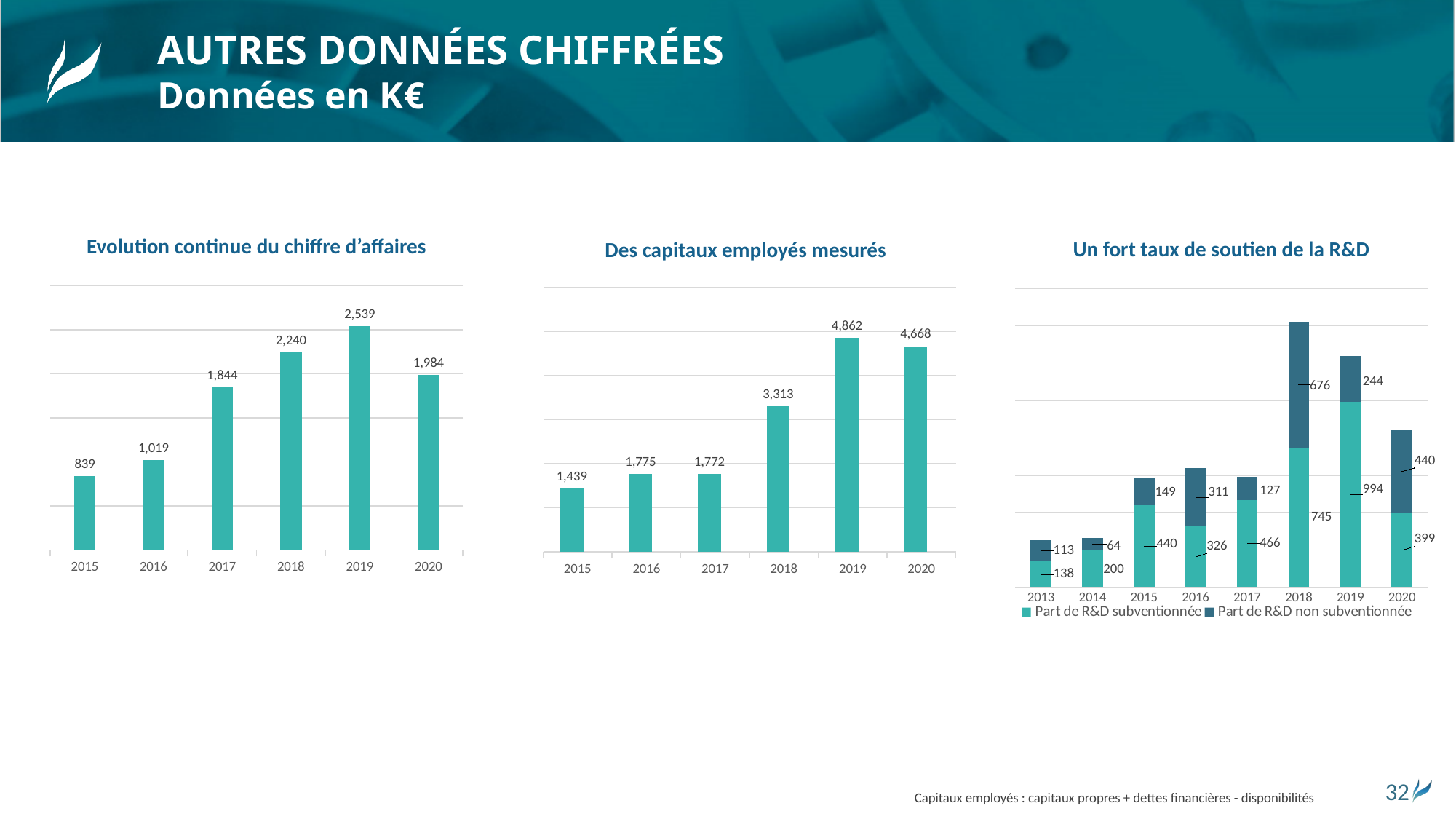
In the chart 'Evolution continue du chiffre d'affaires', what is the value for 2019? 2,539 In the chart 'Des capitaux employés mesurés', what is the value for 2018? 3,313 In the chart 'Un fort taux de soutien de la R&D', what is the value of 'Part de R&D non subventionnée' for 2016? 311 What kind of chart is 'Un fort taux de soutien de la R&D'? Stacked bar chart In the chart 'Des capitaux employés mesurés', is the value for 2018 larger than the value for 2017? Yes, 2018 In the chart 'Des capitaux employés mesurés', which year has the highest value? 2019 In the chart 'Un fort taux de soutien de la R&D', what is the value of 'Part de R&D subventionnée' for 2019? 994 In the chart 'Un fort taux de soutien de la R&D', what is the total of the stacked bar for 2018? 1,421 In the chart 'Un fort taux de soutien de la R&D', how many series does the legend list? 2 In the chart 'Des capitaux employés mesurés', how many years are shown on the x axis? 6 In the chart 'Evolution continue du chiffre d'affaires', what is the difference between the 2019 and 2020 values? 555 In the chart 'Evolution continue du chiffre d'affaires', which year has the lowest value? 2015